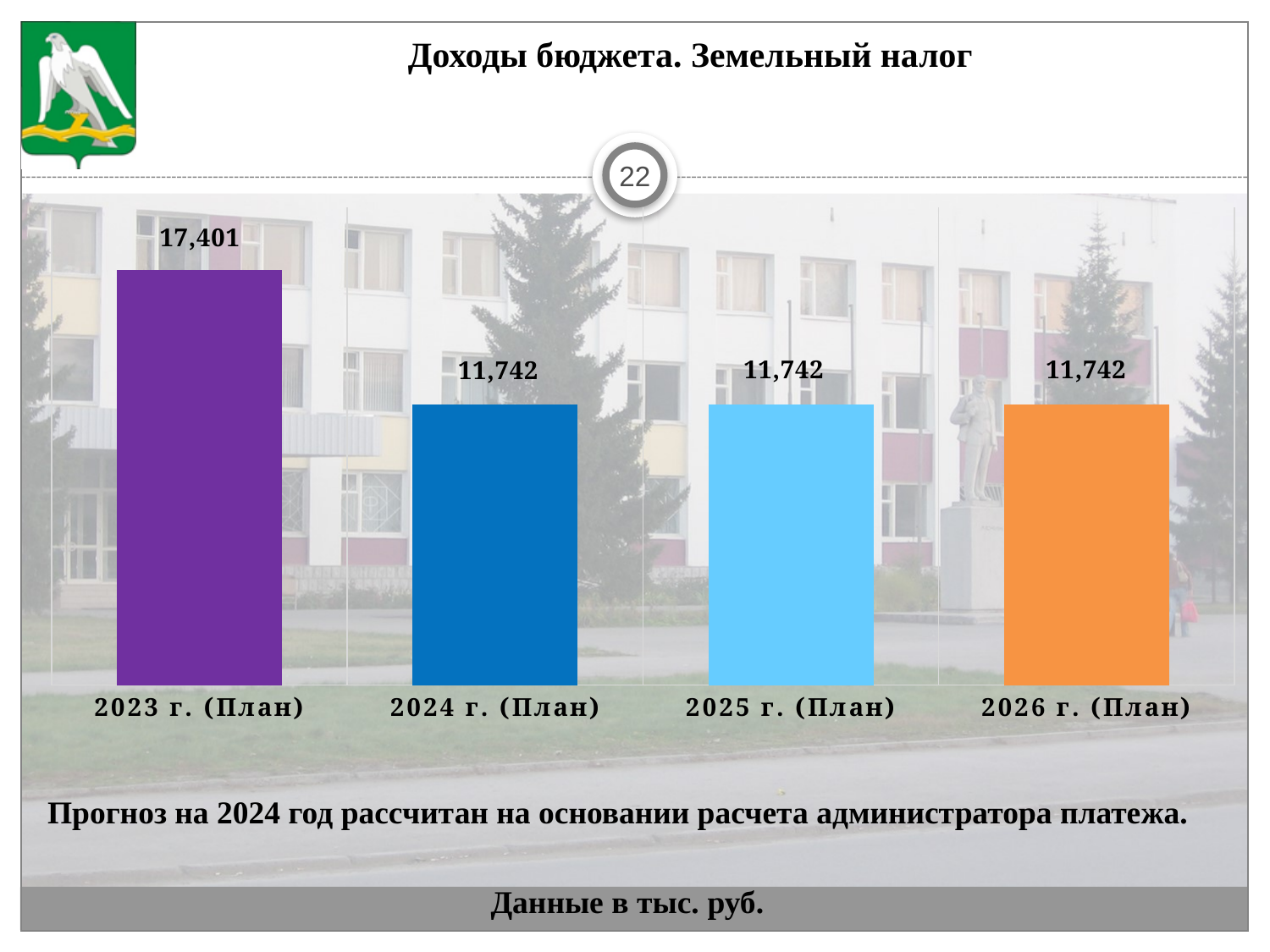
What is the title of the chart? Доходы бюджета. Земельный налог Are the values for 2024 г. (План) and 2025 г. (План) the same? Yes What is the value for 2026 г. (План)? 11,742 In what units are the chart's data given? тыс. руб. Do the values rise or fall from 2023 г. (План) to 2024 г. (План)? Fall How many categories are shown in the chart? 4 What is the value for 2023 г. (План)? 17,401 What is the value for 2024 г. (План)? 11,742 Which is larger, the value for 2023 г. (План) or 2025 г. (План)? 2023 г. (План) Which category has the highest value? 2023 г. (План) What kind of chart is shown on the slide? Bar chart What is the difference between the values for 2023 г. (План) and 2024 г. (План)? 5,659